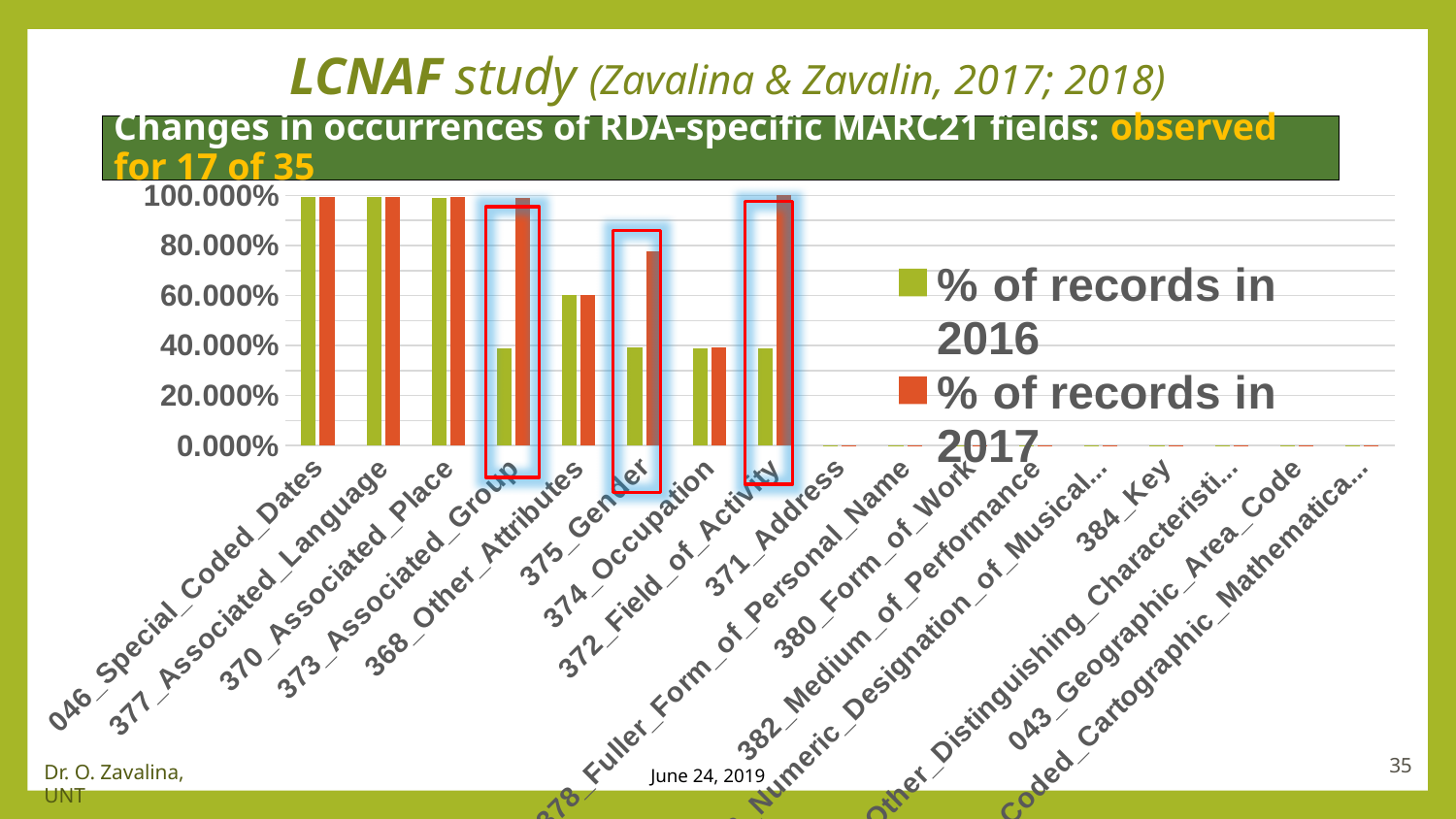
Is the '% of records in 2016' value for 373_Associated_Group greater or less than 60.000%? less For 372_Field_of_Activity, which is larger: the '% of records in 2016' value or the '% of records in 2017' value? % of records in 2017 How many series does the chart's legend list? 2 What kind of chart is shown on the slide? bar chart For 373_Associated_Group, which is larger: the '% of records in 2016' value or the '% of records in 2017' value? % of records in 2017 Which colour represents the '% of records in 2016' series? green Is the '% of records in 2016' value for 368_Other_Attributes greater or less than 40.000%? greater What are the two series named in the chart's legend? % of records in 2016; % of records in 2017 How many categories are shown along the x axis of the chart? 17 Is the '% of records in 2017' value for 375_Gender greater or less than 60.000%? greater